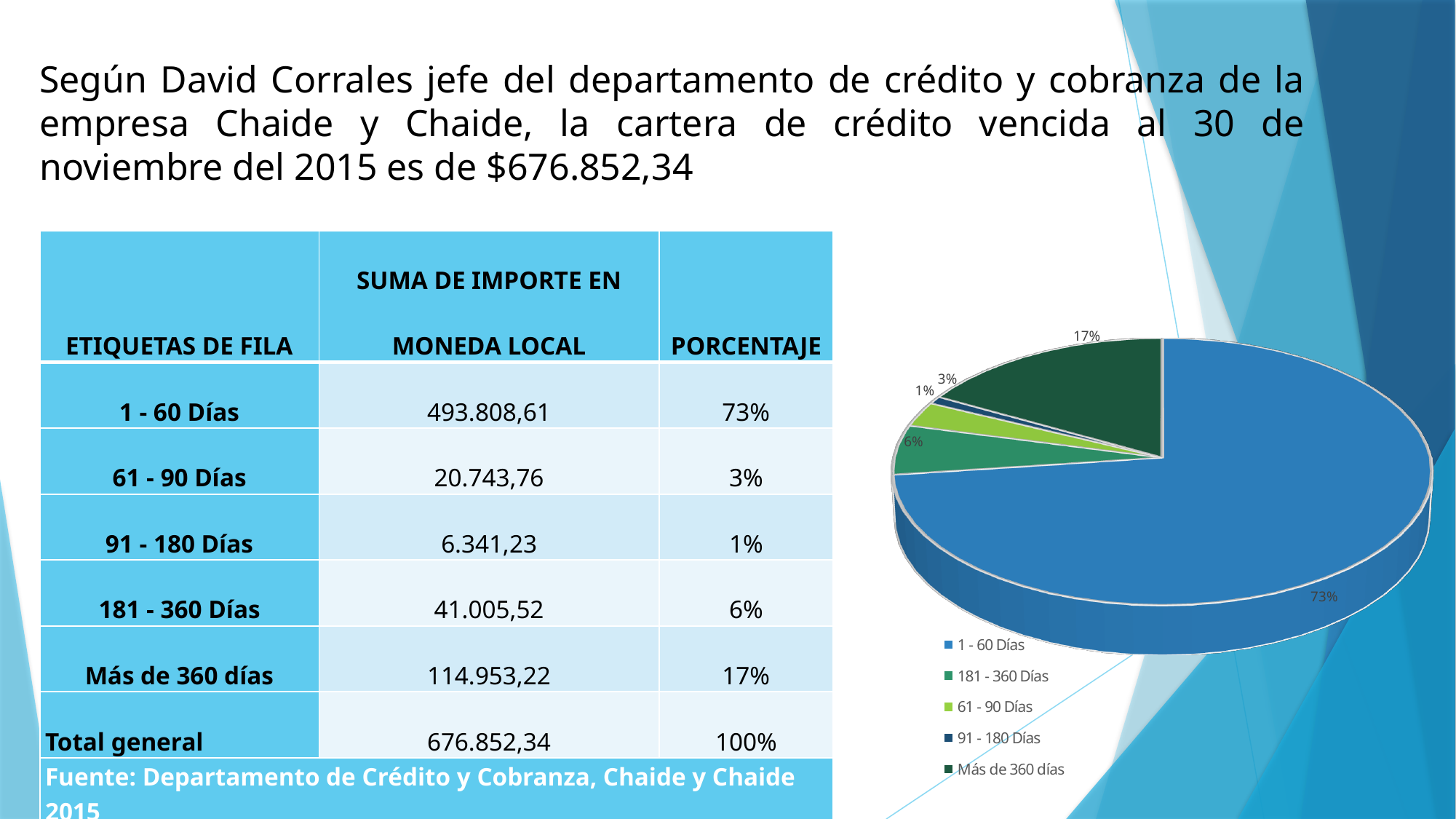
What share of the pie does the 181 - 360 Días slice represent? 6% What kind of chart is shown on the slide? pie chart Which slice is larger in the pie chart, Más de 360 días or 181 - 360 Días? Más de 360 días What is the difference in percentage points between the 1 - 60 Días slice and the Más de 360 días slice? 56% How many entries does the pie chart's legend list? 5 What share of the pie does the 1 - 60 Días slice represent? 73% Which category has the smallest slice in the pie chart? 91 - 180 Días How many slices does the pie chart have? 5 What share of the pie does the Más de 360 días slice represent? 17% Which category has the largest slice in the pie chart? 1 - 60 Días